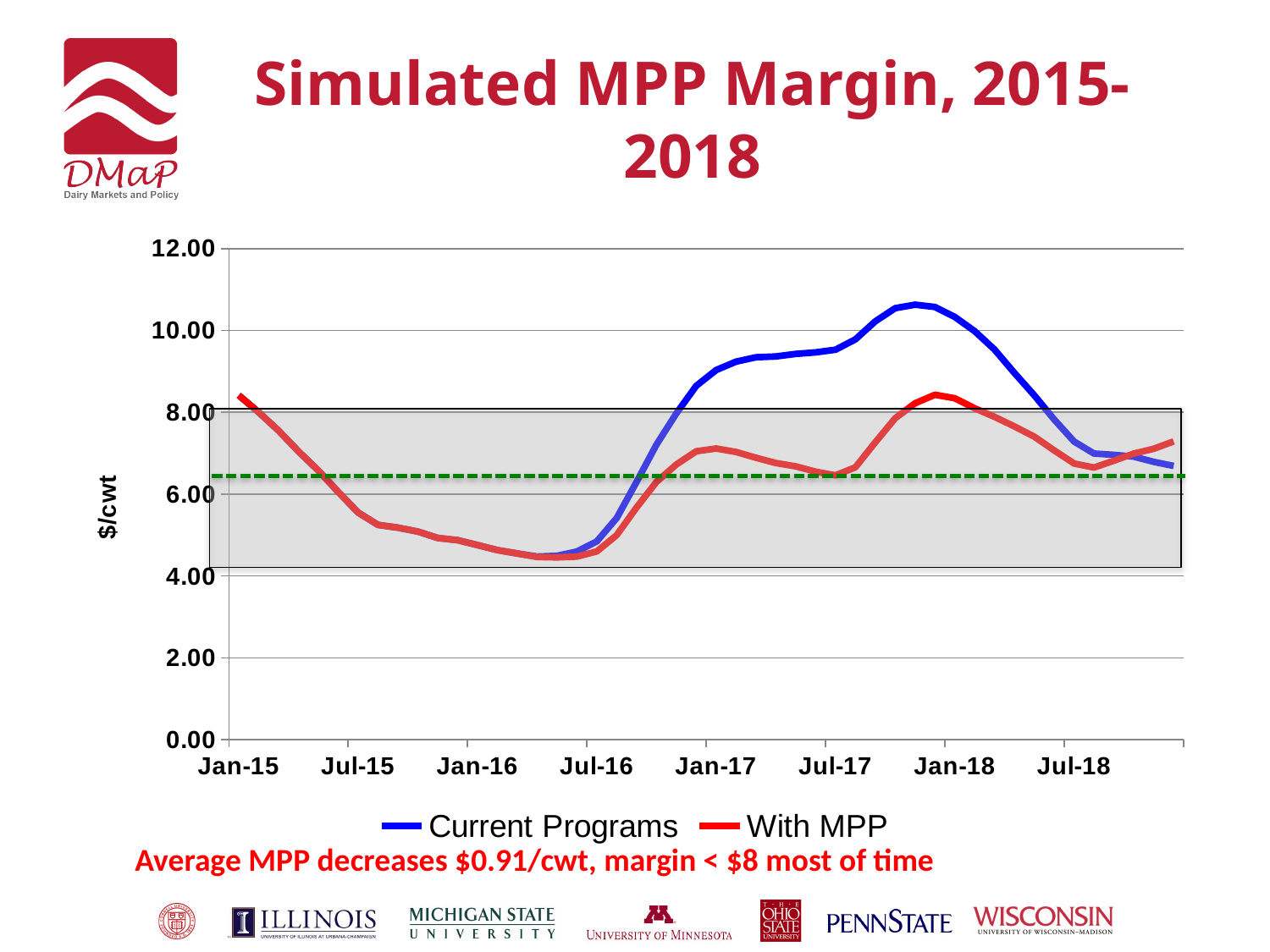
Does the Current Programs line rise or fall between Jan-15 and Jul-16? Fall At Jul-17, which series has the higher value, Current Programs or With MPP? Current Programs Is the value for Current Programs at Jan-16 greater or less than 6.00? less Which series reaches the highest value anywhere on the chart? Current Programs Is the value for Current Programs at Jul-17 greater or less than 8.00? greater What is the label on the vertical axis? $/cwt How many date labels are shown along the x axis? 8 What kind of chart is shown on the slide? Line chart Is the value for With MPP at Jul-17 greater or less than 8.00? less What is the title of the chart? Simulated MPP Margin, 2015-2018 How many series does the legend list? 2